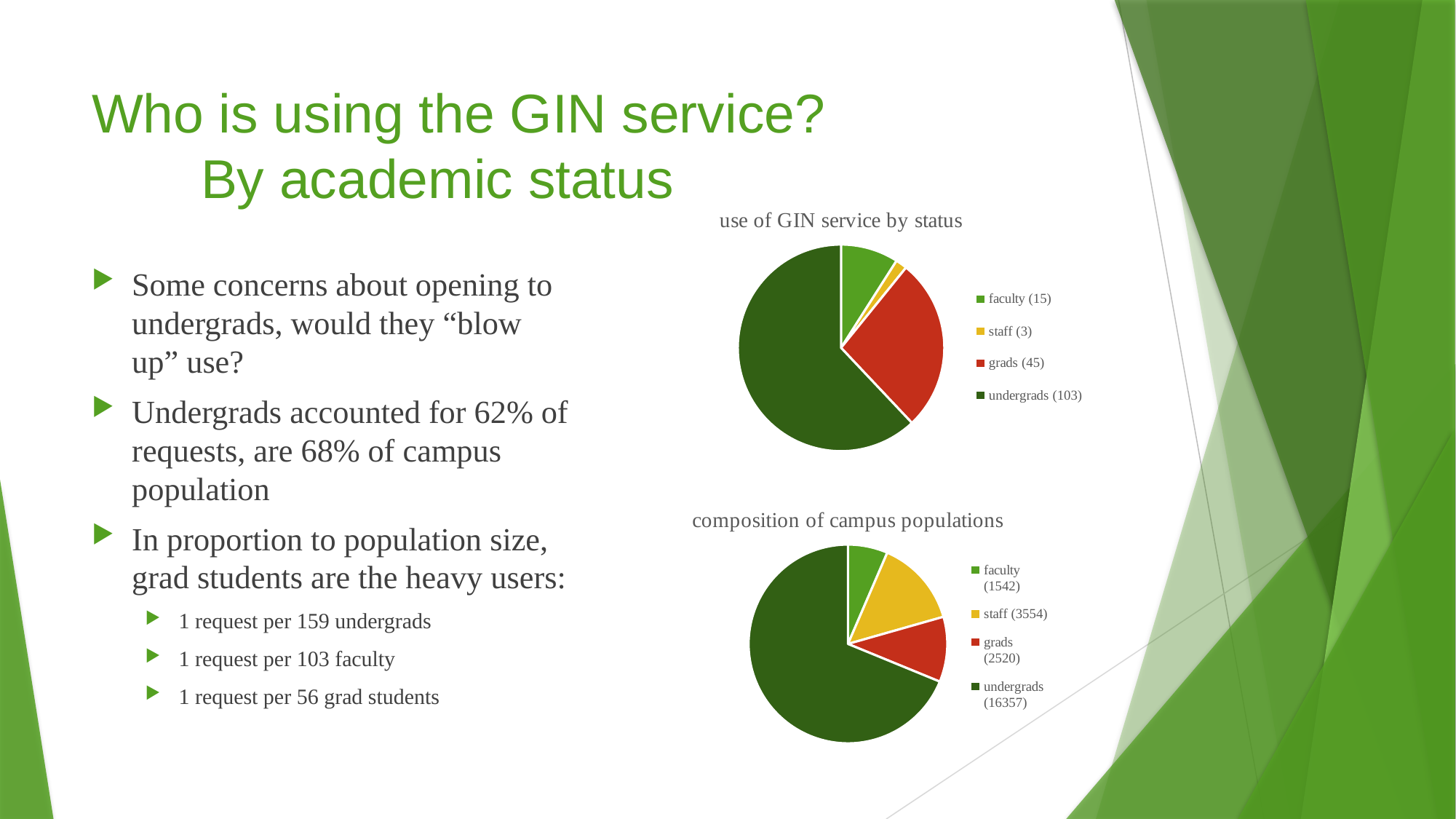
In the 'composition of campus populations' chart, which category has the smallest slice? faculty In the 'use of GIN service by status' chart, which category has the largest slice? undergrads In the 'composition of campus populations' chart, what is the value for undergrads? 16357 In the 'composition of campus populations' chart, what is the difference between the staff value and the faculty value? 2012 In the 'composition of campus populations' chart, which is larger, staff or grads? staff In the 'use of GIN service by status' chart, what is the difference between the undergrads value and the grads value? 58 In the 'composition of campus populations' chart, what is the value for staff? 3554 In the 'use of GIN service by status' chart, how many categories are shown? 4 In the 'use of GIN service by status' chart, what is the value for staff? 3 In the 'use of GIN service by status' chart, what is the value for grads? 45 What type of chart is the 'composition of campus populations' chart? pie chart In the 'use of GIN service by status' chart, which category has the smallest slice? staff